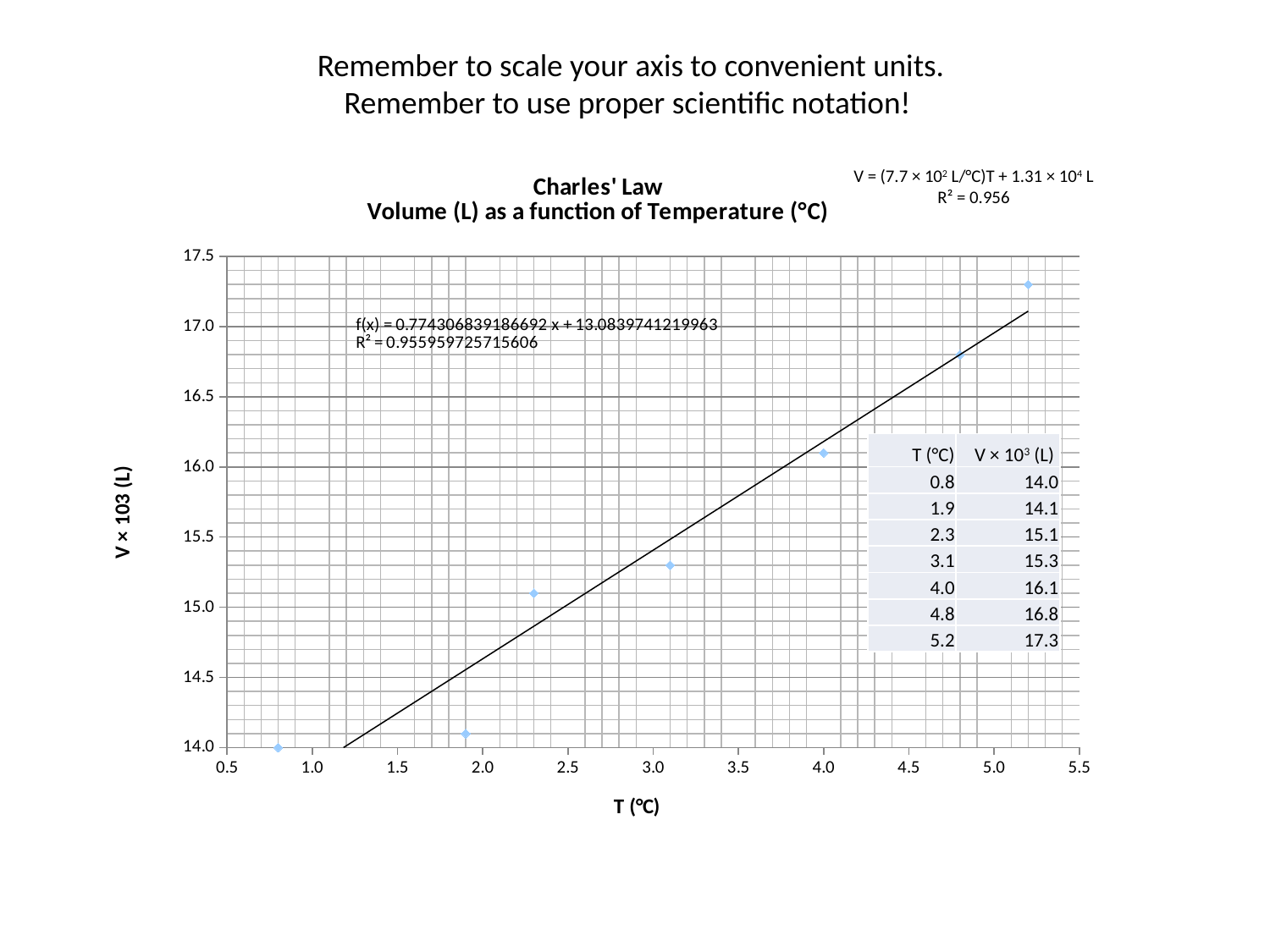
Is the volume value at T = 4.8 °C greater or less than 16.5? greater Do the plotted volume values rise or fall as temperature increases along the x axis? rise What is the difference between the highest and lowest volume values in the table (V × 10³ L)? 3.3 What kind of chart is shown on the slide? Scatter chart At which temperature is the plotted volume highest? 5.2 What is the R² value of the trendline as given in the equation at the top right of the chart? 0.956 How many data points are plotted on the chart? 7 What is the title of the chart? Charles' Law Volume (L) as a function of Temperature (°C) Which has the larger volume: T = 4.0 °C or T = 3.1 °C? 4.0 At which temperature is the plotted volume lowest? 0.8 According to the data table, what is the volume (V × 10³ L) at T = 4.8 °C? 16.8 According to the data table, what is the volume (V × 10³ L) at T = 2.3 °C? 15.1